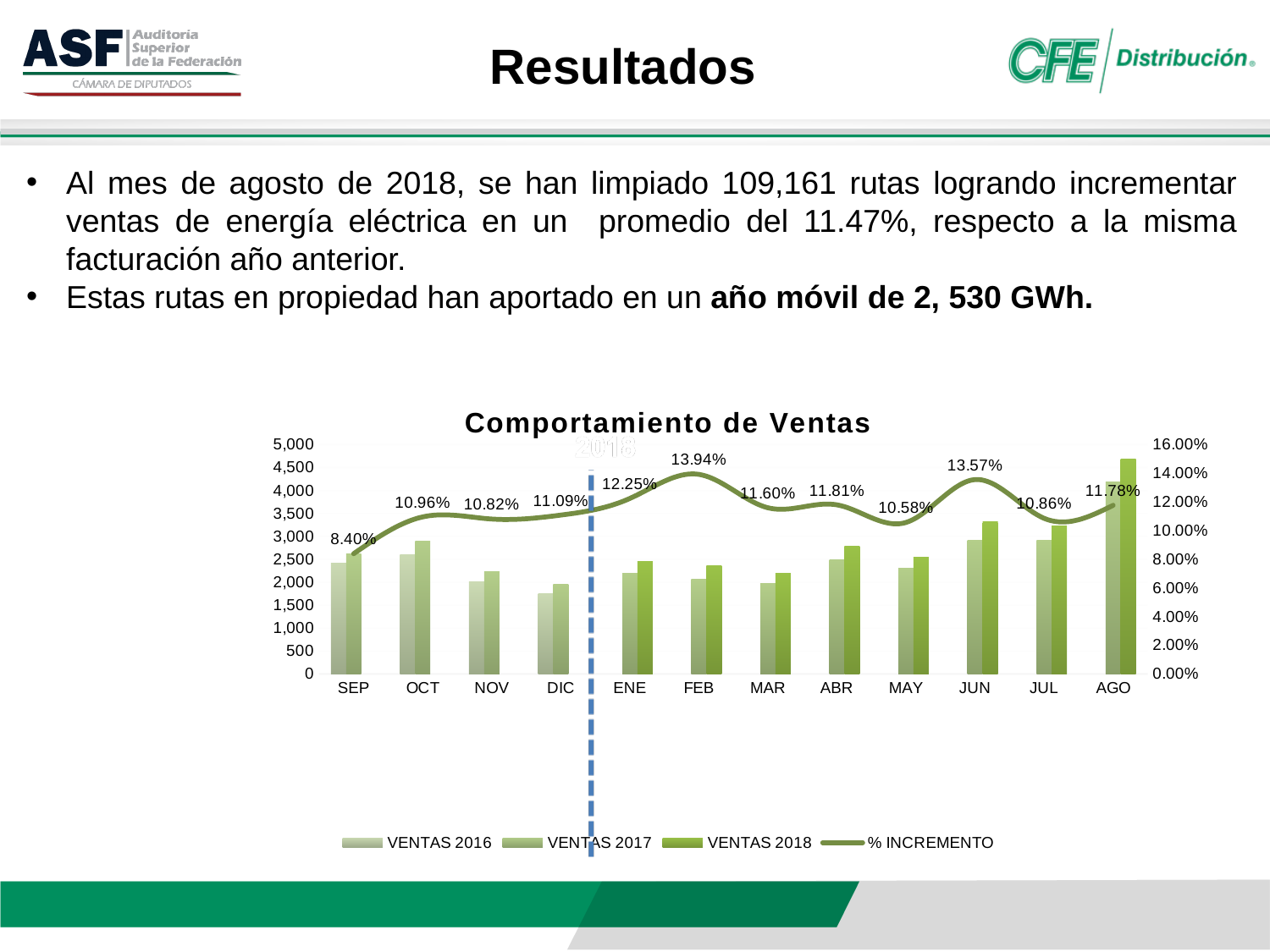
What is the % INCREMENTO value for FEB in the Comportamiento de Ventas chart? 13.94% Which month has the highest % INCREMENTO? FEB How many months are shown on the x axis of the chart? 12 Which is larger, the % INCREMENTO for ENE or for DIC? ENE Does the % INCREMENTO line rise or fall from MAY to JUN? rise What is the difference between the % INCREMENTO for FEB and for SEP? 5.54% What is the % INCREMENTO value for SEP? 8.40% What is the % INCREMENTO value for JUN? 13.57% Which month has the lowest % INCREMENTO? SEP Is the VENTAS 2016 bar for DIC greater or less than 2,000? less Is the VENTAS 2018 bar for AGO greater or less than 4,000? greater How many series does the legend list? 4